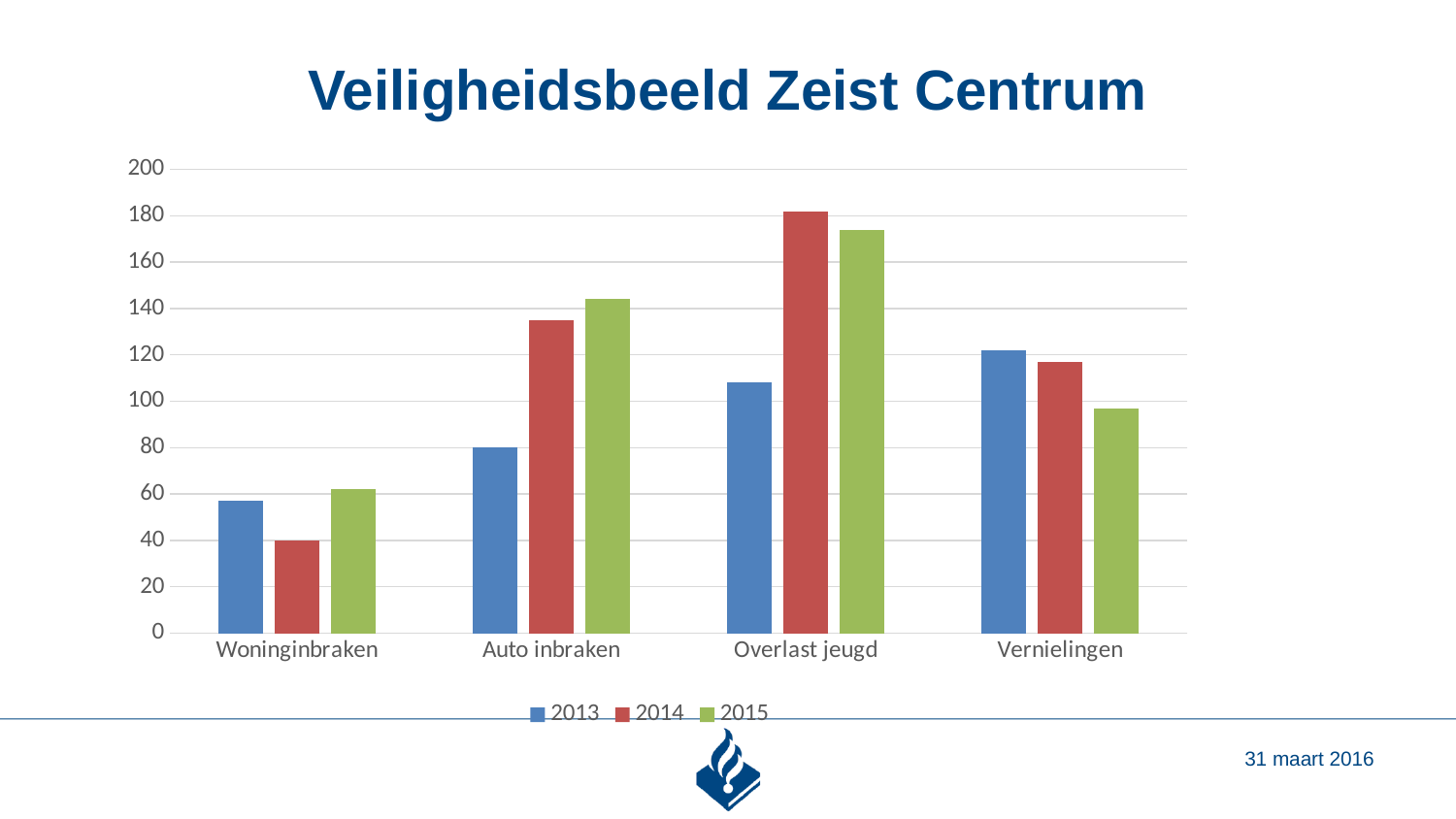
What kind of chart is shown on the slide? bar chart Is the value for Vernielingen in 2015 greater or less than 100? less Is the value for Auto inbraken in 2015 greater or less than 140? greater Do the values for Auto inbraken rise or fall from 2013 to 2015? rise Which category has the lowest bar in the chart? Woninginbraken How many series does the legend list? 3 Which is larger for Woninginbraken: the 2014 value or the 2015 value? 2015 Which category has the highest bar in the chart? Overlast jeugd What is the title of the chart? Veiligheidsbeeld Zeist Centrum How many categories are shown on the x axis? 4 Which is larger for Vernielingen: the 2013 value or the 2015 value? 2013